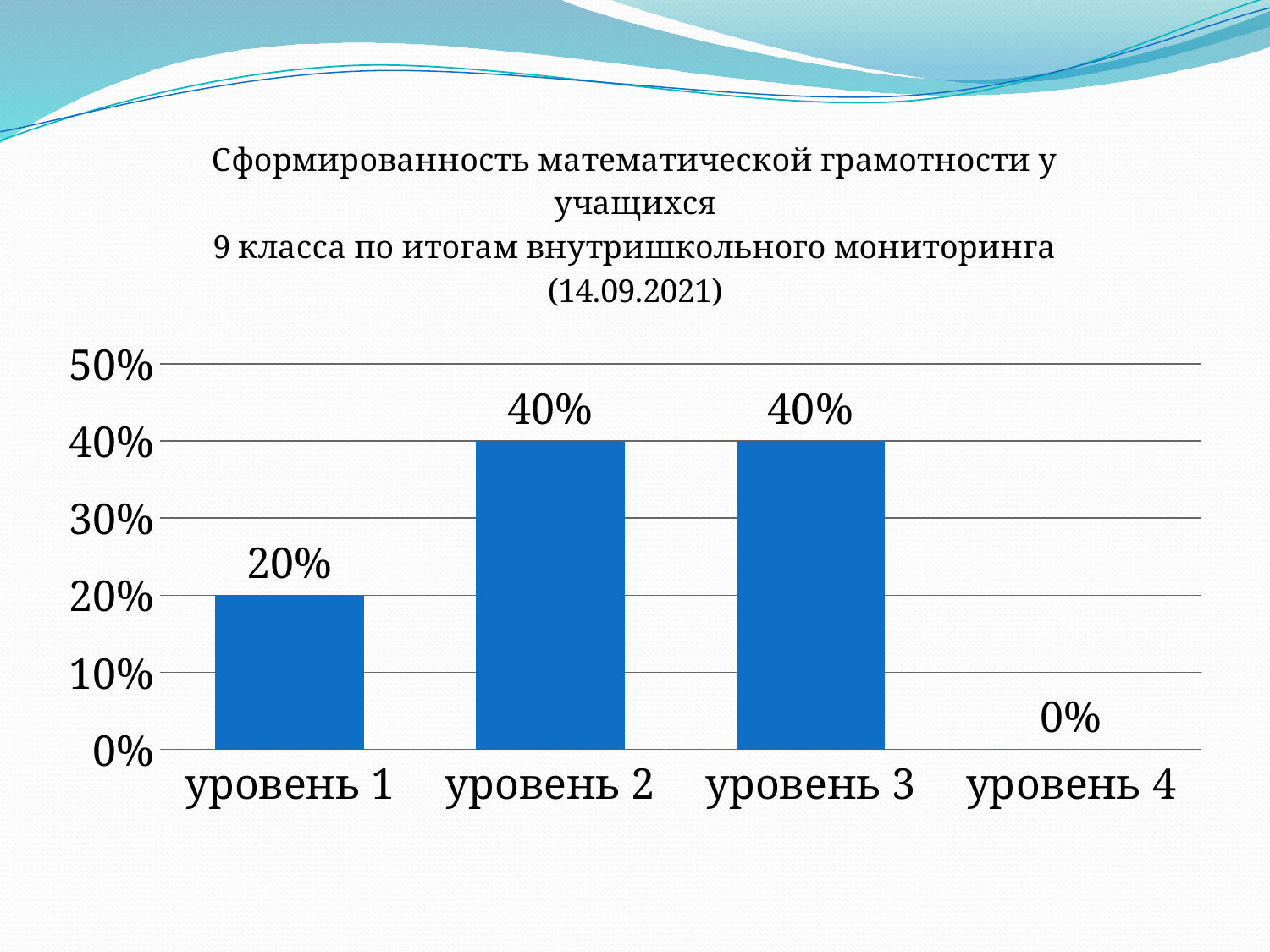
Which category has the lowest value? уровень 4 Which is larger, the value for уровень 1 or the value for уровень 3? уровень 3 How many categories are shown on the x axis? 4 What is the difference between the values for уровень 2 and уровень 1? 20% Is the value for уровень 1 greater or less than 30%? less Do the values for уровень 2 and уровень 3 differ? No, both are 40% What kind of chart is shown on the slide? bar chart What is the date given in the chart title? 14.09.2021 What is the value for уровень 4? 0% What is the value for уровень 2? 40% What is the value for уровень 1? 20% What is the highest value shown on the y axis? 50%